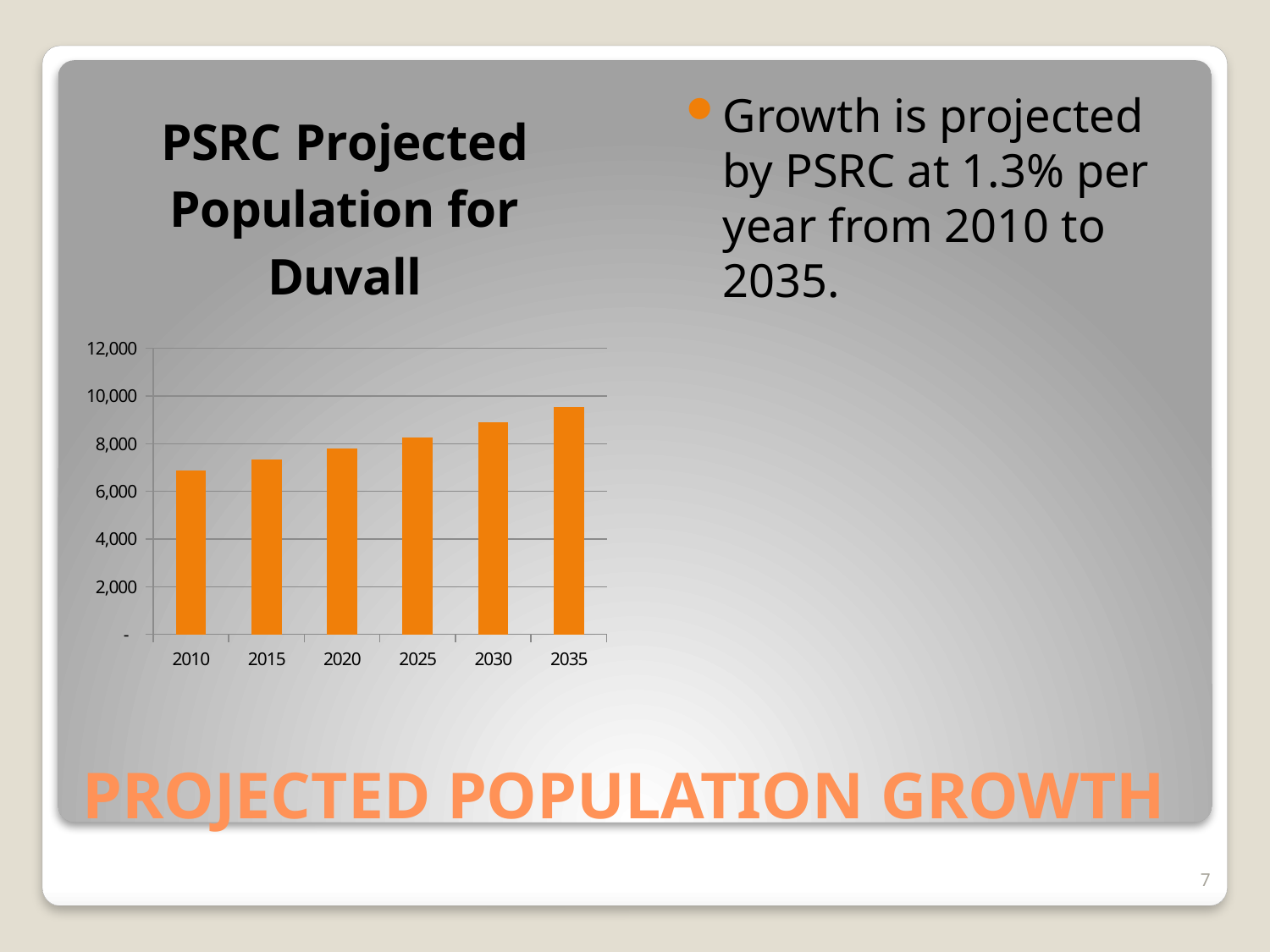
How many years are shown on the x axis of the chart? 6 Is the value for 2010 greater or less than 6,000? greater Which year has the highest projected population in the chart? 2035 What kind of chart is shown on the slide? bar chart What colour are the bars in the chart? orange Is the value for 2035 greater or less than 10,000? less What is the title of the chart? PSRC Projected Population for Duvall Is the value for 2010 greater or less than 8,000? less Do the values in the chart rise or fall from 2010 to 2035? rise Which year has the lowest projected population in the chart? 2010 Which is larger, the value for 2015 or the value for 2030? 2030